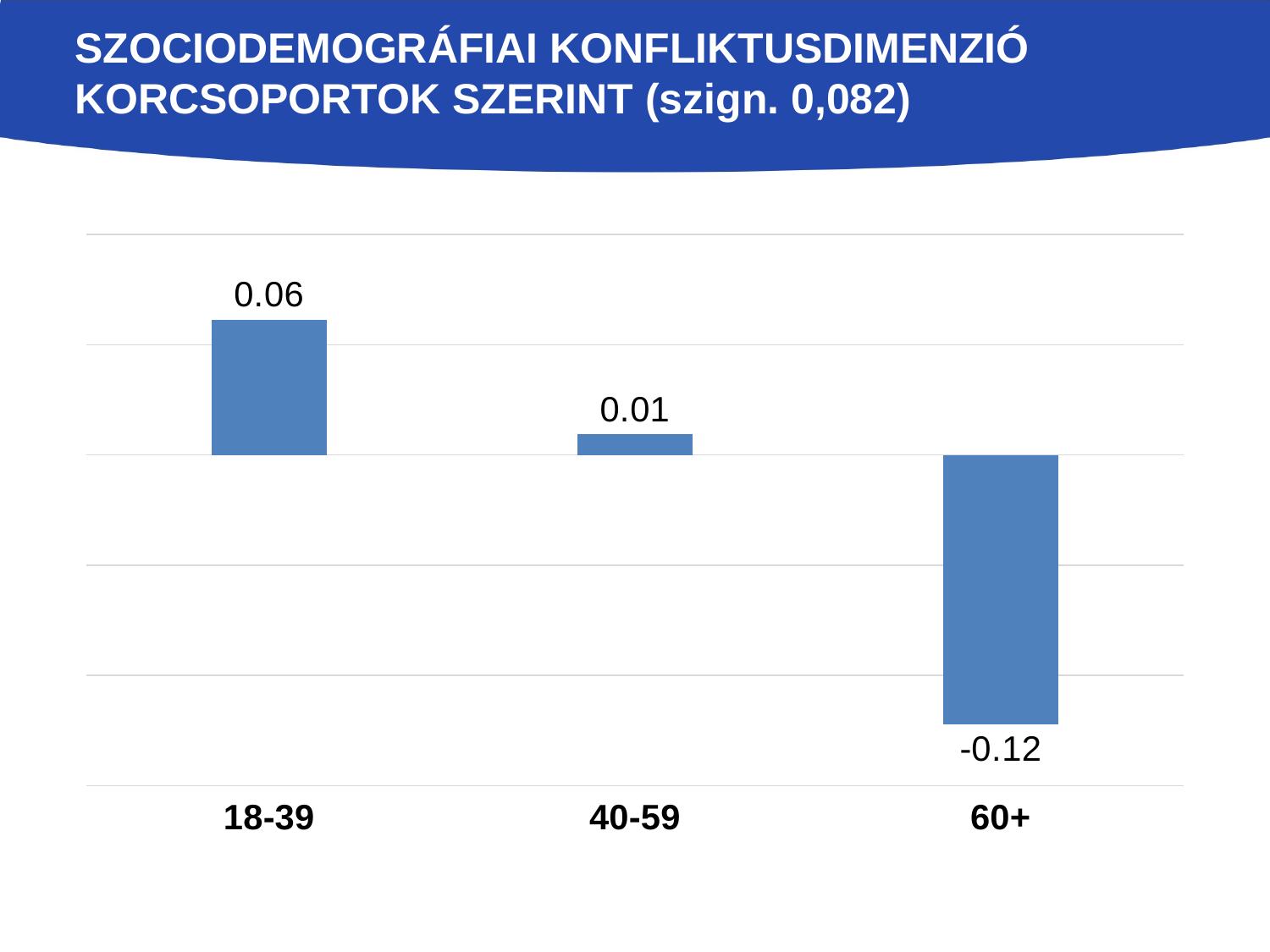
What is the difference between the values for 18-39 and 60+? 0.18 What is the difference between the values for 18-39 and 40-59? 0.05 What is the value for the 60+ age group? -0.12 What is the value for the 18-39 age group? 0.06 What kind of chart is shown on the slide? Bar chart What is the value for the 40-59 age group? 0.01 Which age group has the highest value? 18-39 Which is larger, the value for 40-59 or the value for 60+? 40-59 How many age groups are shown in the chart? 3 Which age group has the lowest value? 60+ Which age group has a negative value? 60+ Do the values rise or fall from the 18-39 group to the 60+ group? Fall